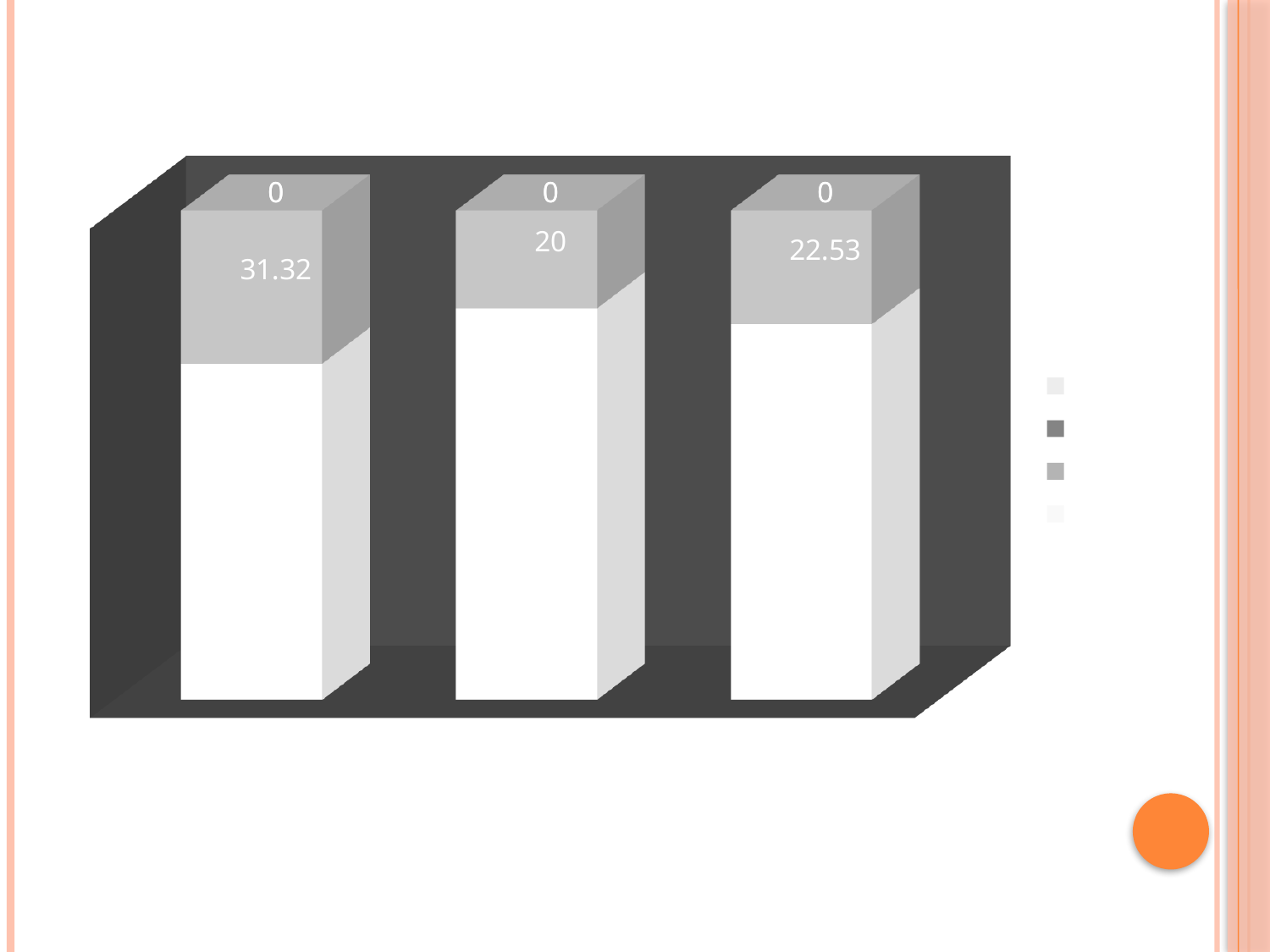
How many entries does the legend on the right of the chart show? 4 What value is labelled on the grey segment of the middle bar? 20 Which bar has the smallest labelled grey segment value? The middle bar (20) What is the difference between the grey segment values of the left bar and the middle bar? 11.32 What value is labelled on the grey segment of the left bar? 31.32 Which bar has the largest labelled grey segment value? The left bar (31.32) How many bars are plotted in the chart? 3 What kind of chart is shown on the slide? Stacked bar chart What value is labelled on the grey segment of the right bar? 22.53 Is the grey segment value of the left bar larger or smaller than that of the right bar? Larger What is the difference between the grey segment values of the right bar and the middle bar? 2.53 What value is printed at the very top of each bar? 0